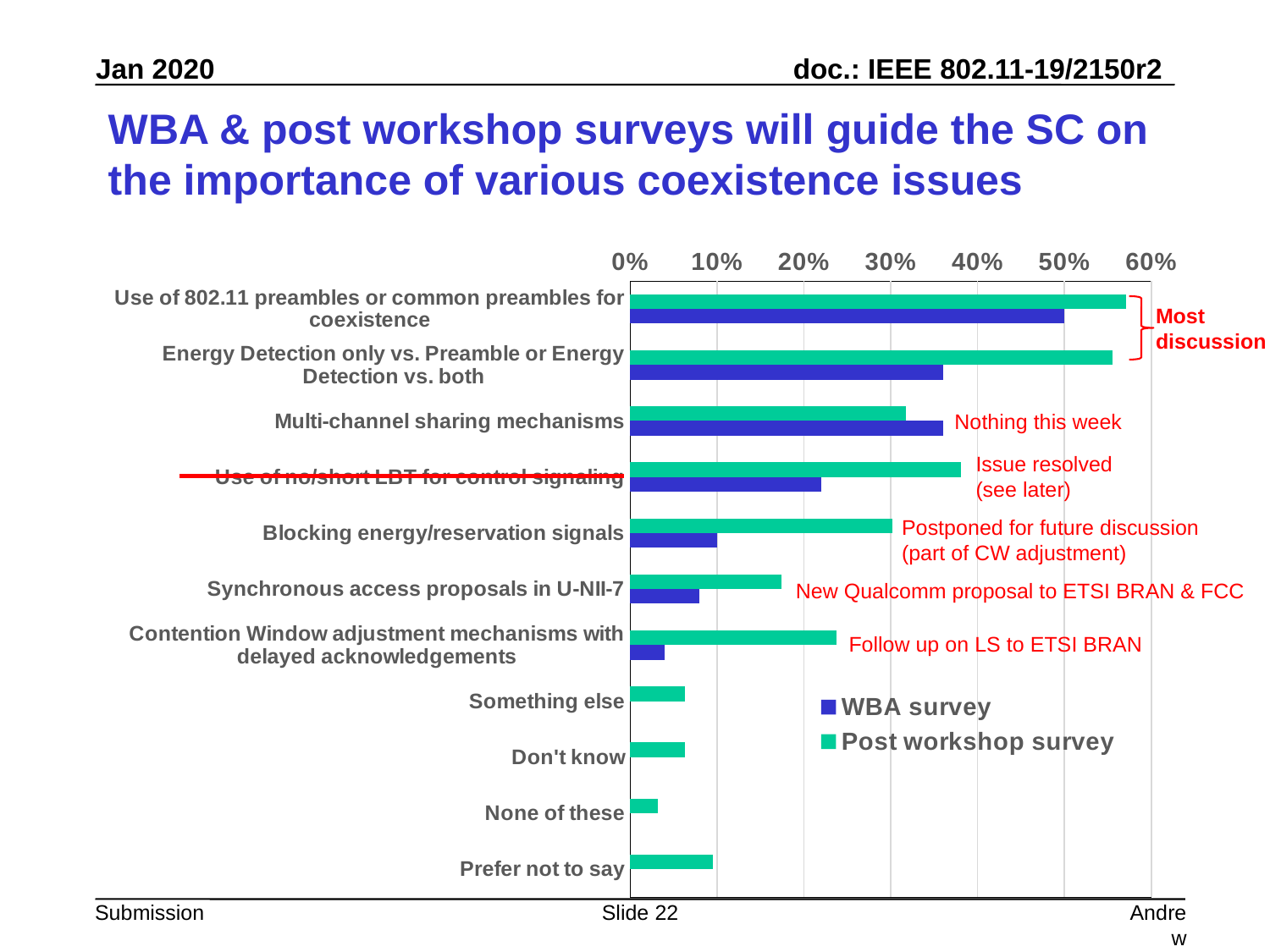
Is the Post workshop survey value for 'Synchronous access proposals in U-NII-7' greater or less than 20%? less Is the WBA survey value for 'Energy Detection only vs. Preamble or Energy Detection vs. both' greater or less than 30%? greater How many series does the legend list? 2 Which has the larger Post workshop survey value: 'Synchronous access proposals in U-NII-7' or 'Contention Window adjustment mechanisms with delayed acknowledgements'? Contention Window adjustment mechanisms with delayed acknowledgements Which category has the highest WBA survey value? Use of 802.11 preambles or common preambles for coexistence For 'Blocking energy/reservation signals', which series has the larger value, WBA survey or Post workshop survey? Post workshop survey How many categories are plotted on the chart? 11 What kind of chart is shown on the slide? Bar chart Which category has the lowest Post workshop survey value? None of these Which category label on the chart is struck through? Use of no/short LBT for control signaling Is the Post workshop survey value for 'Use of 802.11 preambles or common preambles for coexistence' greater or less than 50%? greater